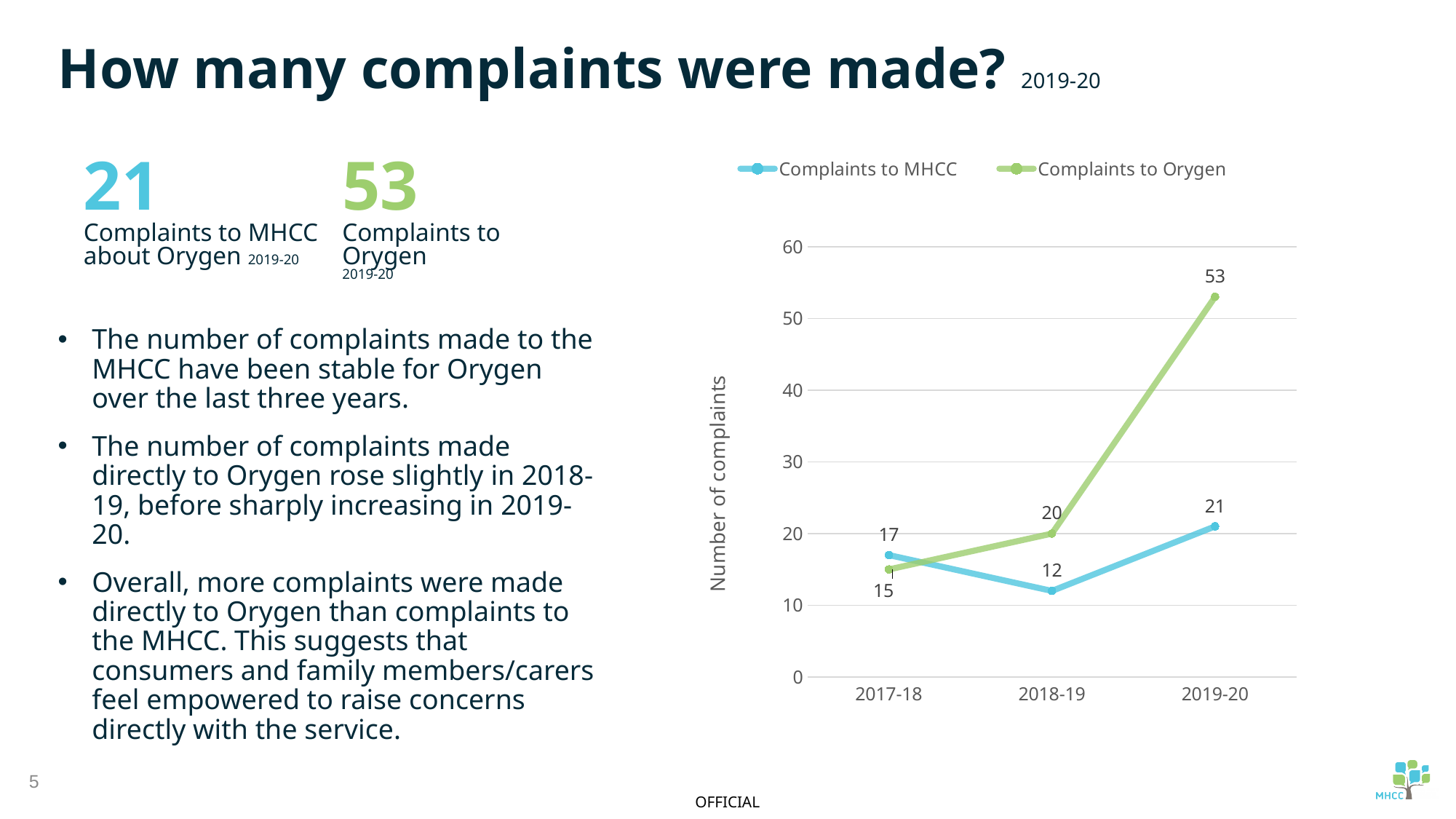
Which series has the larger value in 2018-19, Complaints to MHCC or Complaints to Orygen? Complaints to Orygen What is the label of the y axis of the chart? Number of complaints In which year is the value for Complaints to Orygen highest? 2019-20 What is the value for Complaints to Orygen in 2019-20? 53 What is the value for Complaints to MHCC in 2017-18? 17 What is the value for Complaints to MHCC in 2018-19? 12 How many years are plotted on the x axis of the chart? 3 What is the difference between Complaints to Orygen and Complaints to MHCC in 2019-20? 32 What is the value for Complaints to Orygen in 2017-18? 15 What type of chart is shown on the slide? line chart How many series does the chart legend list? 2 In which year is the value for Complaints to MHCC lowest? 2018-19